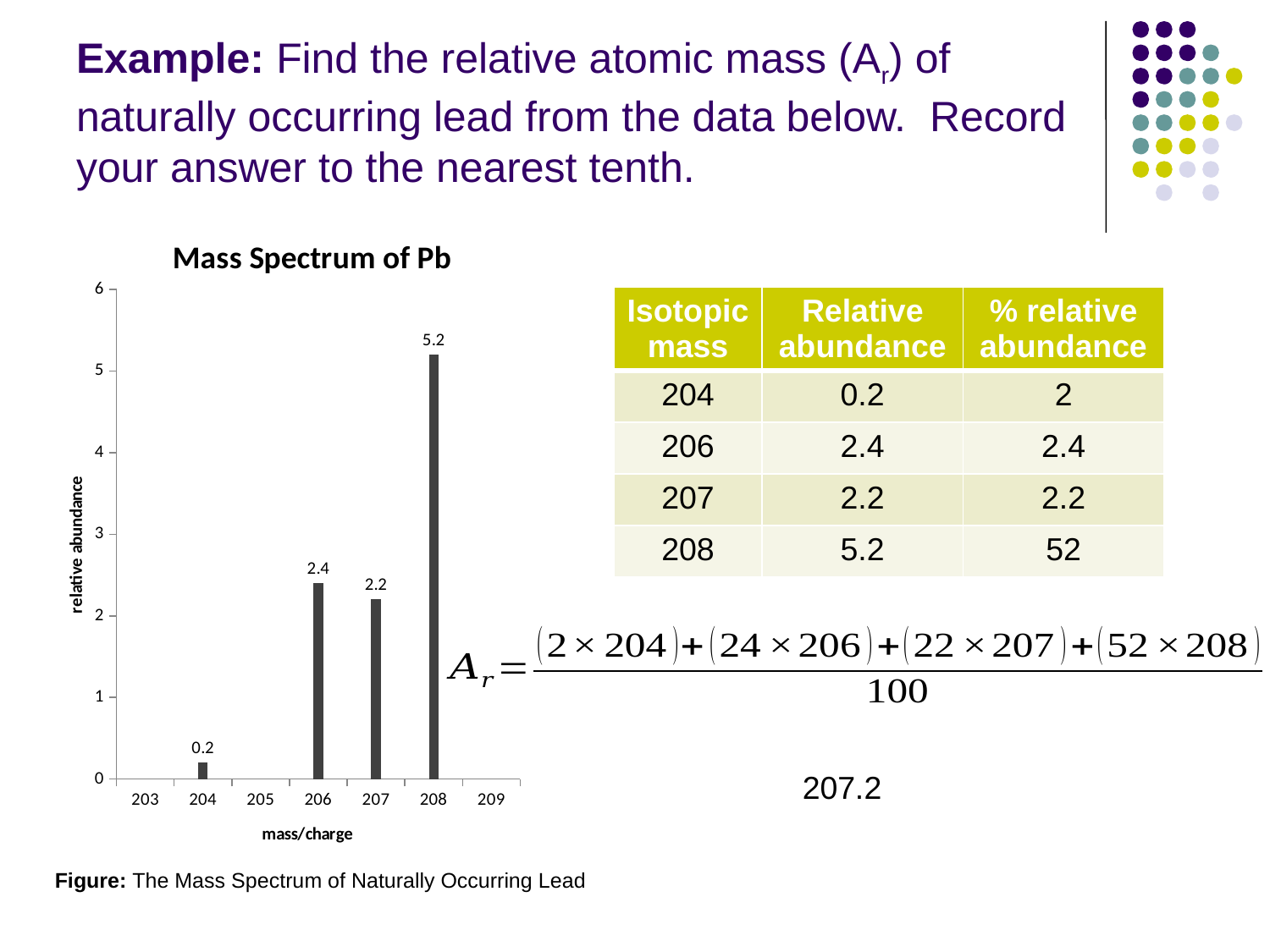
What kind of chart is the Mass Spectrum of Pb? bar chart What is the label of the x axis in the Mass Spectrum of Pb chart? mass/charge What is the relative abundance at mass/charge 204 in the Mass Spectrum of Pb chart? 0.2 What is the relative abundance at mass/charge 206 in the Mass Spectrum of Pb chart? 2.4 How many bars are plotted in the Mass Spectrum of Pb chart? 4 What is the difference in relative abundance between mass/charge 208 and mass/charge 206 in the Mass Spectrum of Pb chart? 2.8 Is the relative abundance at mass/charge 208 in the Mass Spectrum of Pb chart greater or less than 5? greater Which mass/charge value has the highest relative abundance in the Mass Spectrum of Pb chart? 208 What is the relative abundance at mass/charge 207 in the Mass Spectrum of Pb chart? 2.2 Which mass/charge value has the lowest relative abundance in the Mass Spectrum of Pb chart? 204 What is the relative abundance at mass/charge 208 in the Mass Spectrum of Pb chart? 5.2 In the Mass Spectrum of Pb chart, which has a larger relative abundance, mass/charge 206 or mass/charge 207? 206